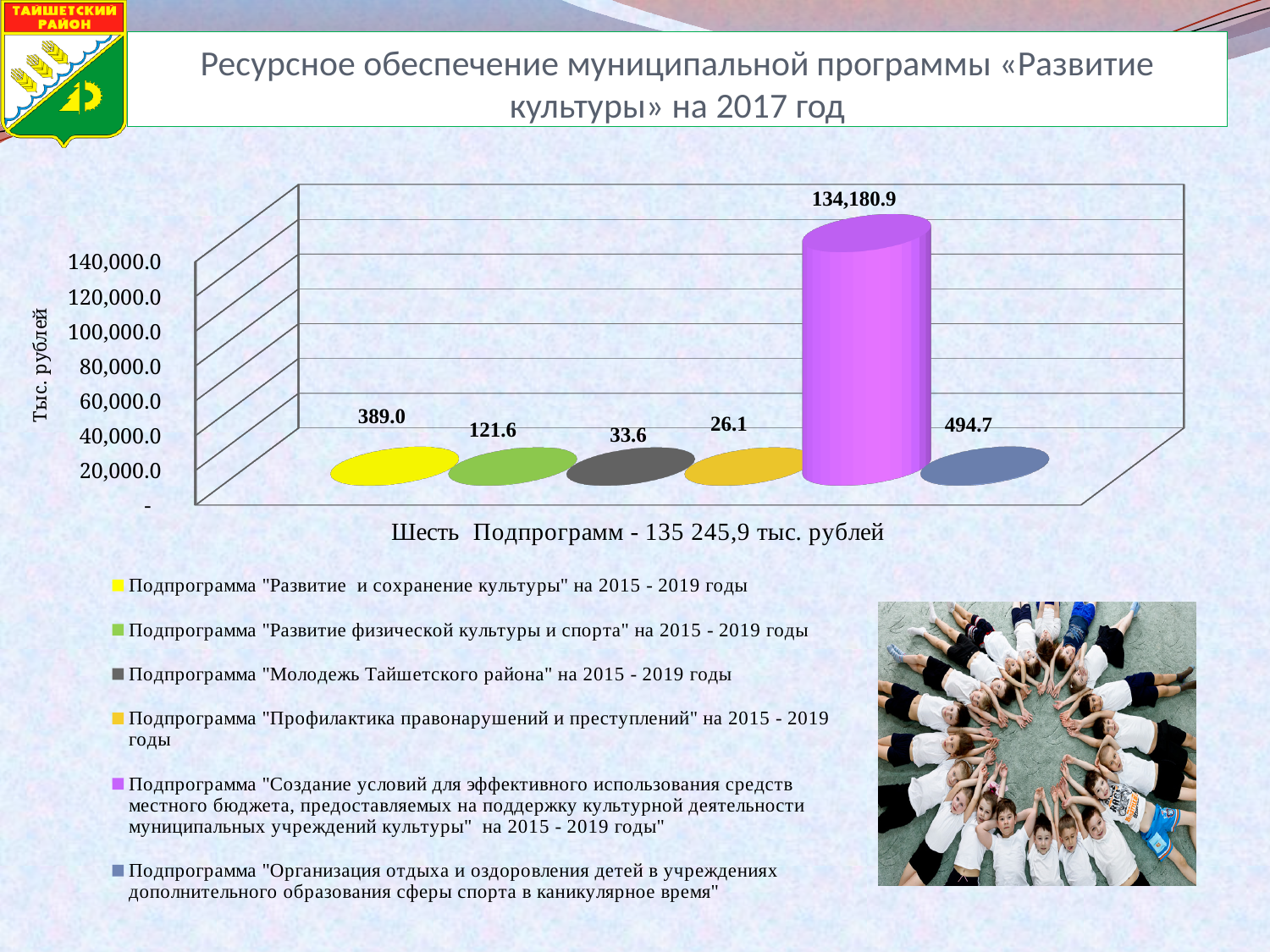
How many subprograms does the legend list? 6 What is the value shown for the subprogram "Развитие и сохранение культуры" на 2015 - 2019 годы? 389.0 What is the difference between the values for "Организация отдыха и оздоровления детей..." (494.7) and "Развитие и сохранение культуры" (389.0)? 105.7 What type of chart is shown on the slide? Bar chart Which subprogram has the lowest value on the chart? Подпрограмма "Профилактика правонарушений и преступлений" на 2015 - 2019 годы What unit is given on the vertical axis label of the chart? Тыс. рублей Which is larger: the value for "Развитие физической культуры и спорта" or the value for "Молодежь Тайшетского района"? Развитие физической культуры и спорта Which subprogram has the highest value on the chart? Подпрограмма "Создание условий для эффективного использования средств местного бюджета, предоставляемых на поддержку культурной деятельности муниципальных учреждений культуры" на 2015 - 2019 годы What is the value shown for the subprogram "Организация отдыха и оздоровления детей в учреждениях дополнительного образования сферы спорта в каникулярное время"? 494.7 What is the value shown for the subprogram "Профилактика правонарушений и преступлений" на 2015 - 2019 годы? 26.1 What is the value shown for the subprogram "Развитие физической культуры и спорта" на 2015 - 2019 годы? 121.6 What is the value shown for the subprogram "Молодежь Тайшетского района" на 2015 - 2019 годы? 33.6